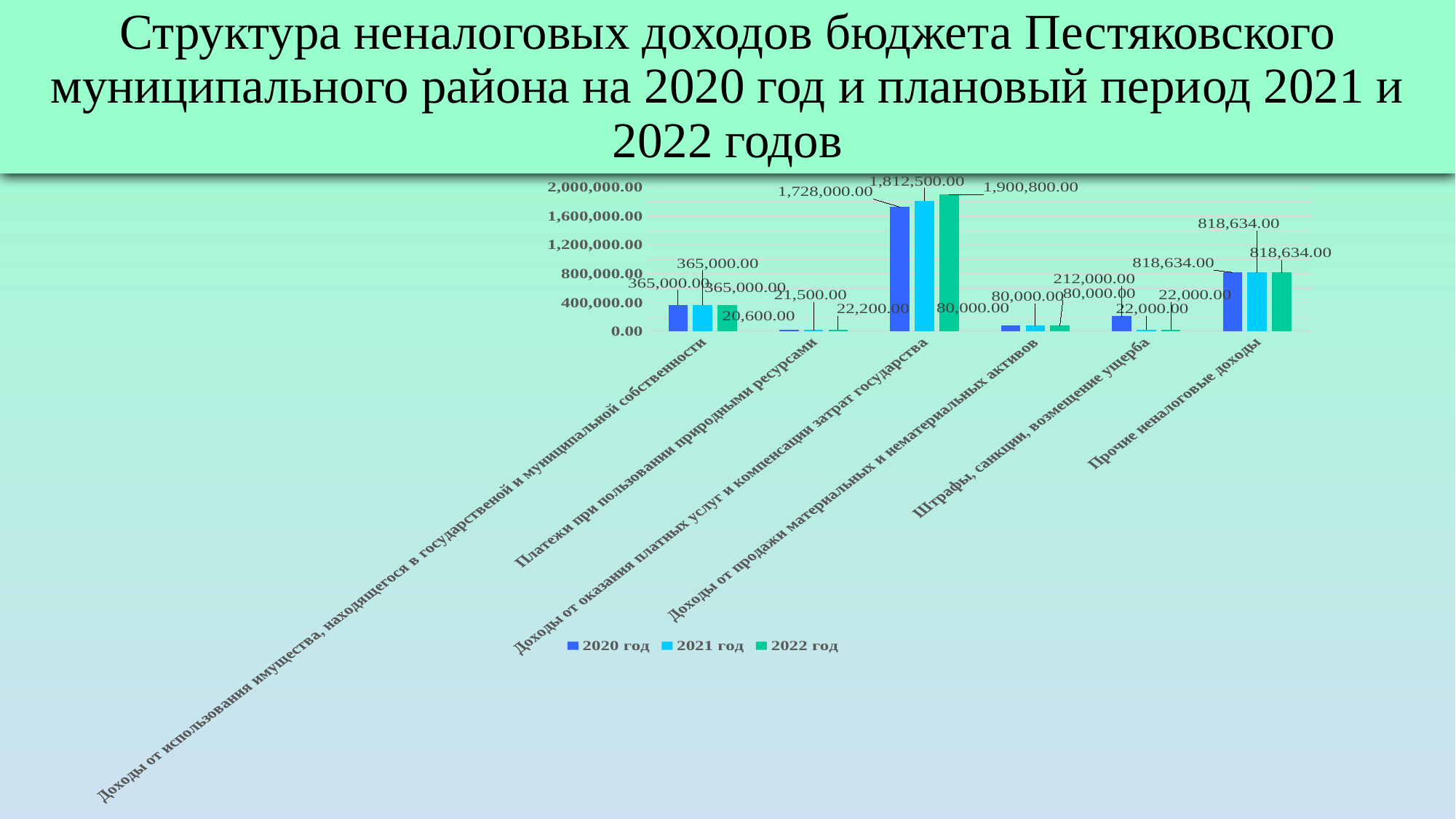
What is the value for 2022 год in the category 'Доходы от оказания платных услуг и компенсации затрат государства'? 1,900,800.00 What type of chart is shown on the slide? bar chart How many series does the legend list? 3 What is the value for 2020 год in the category 'Штрафы, санкции, возмещение ущерба'? 212,000.00 Which is larger in the category 'Штрафы, санкции, возмещение ущерба': the value for 2020 год or for 2021 год? 2020 год What is the difference between the 2022 год and 2020 год values for 'Доходы от оказания платных услуг и компенсации затрат государства'? 172,800.00 What are the three legend entries of the chart? 2020 год, 2021 год, 2022 год How many categories are shown on the x axis of the chart? 6 Do the values for 'Доходы от оказания платных услуг и компенсации затрат государства' rise or fall from 2020 год to 2022 год? rise Which category has the lowest value for 2022 год? Платежи при пользовании природными ресурсами Which category has the highest value for 2020 год? Доходы от оказания платных услуг и компенсации затрат государства What is the value for 2021 год in the category 'Прочие неналоговые доходы'? 818,634.00